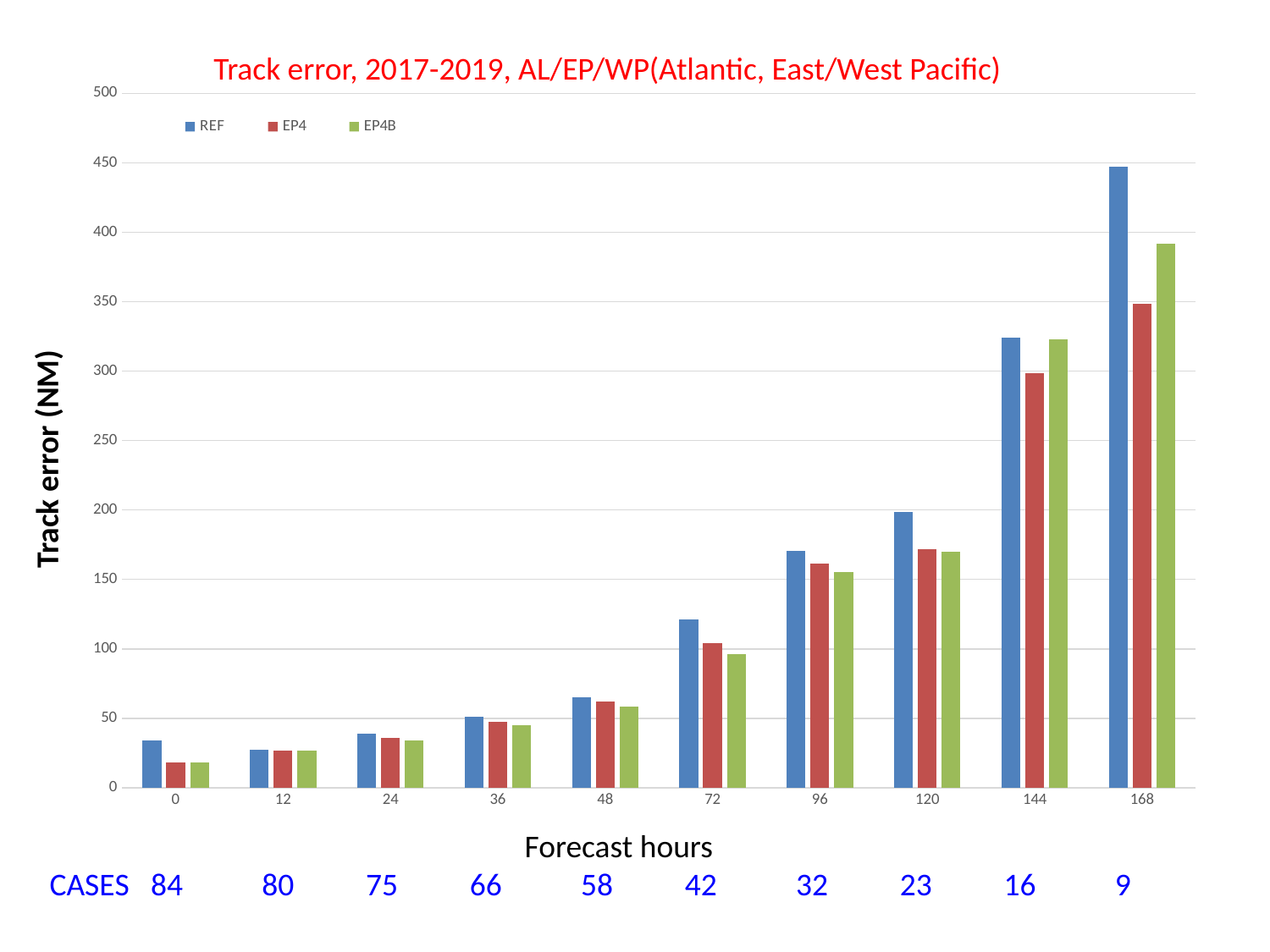
How many forecast hours are plotted along the x axis? 10 At 168 forecast hours, which is larger, EP4 or EP4B? EP4B At 72 forecast hours, which is larger, REF or EP4B? REF What is the title of the chart? Track error, 2017-2019, AL/EP/WP(Atlantic, East/West Pacific) Do the REF track error values rise or fall as forecast hours increase? rise Is the REF value at 120 forecast hours greater or less than 150? greater How many series does the legend list? 3 At which forecast hour is the REF track error lowest? 12 What kind of chart is shown on the slide? bar chart Is the REF value at 168 forecast hours greater or less than 400? greater Is the EP4 value at 168 forecast hours greater or less than 400? less At which forecast hour is the REF track error highest? 168